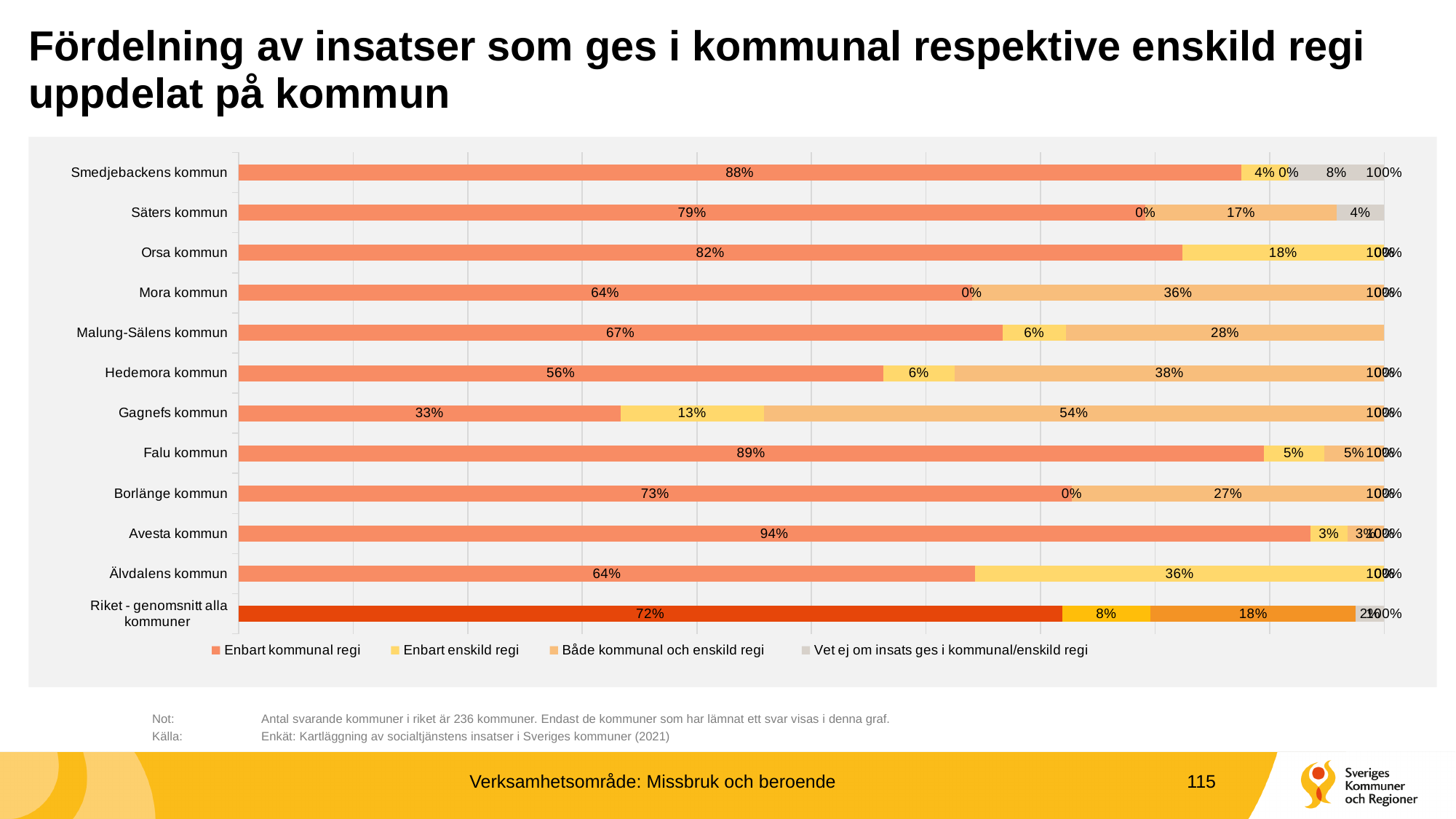
What is the value of 'Vet ej om insats ges i kommunal/enskild regi' for Säters kommun? 4% What kind of chart is shown on the slide? bar chart Which has a larger 'Enbart kommunal regi' value, Mora kommun or Borlänge kommun? Borlänge kommun What is the value of 'Enbart enskild regi' for Älvdalens kommun? 36% Which category has the highest value for 'Både kommunal och enskild regi'? Gagnefs kommun How many categories (rows) are plotted in the chart? 12 Which category has the lowest value for 'Enbart kommunal regi'? Gagnefs kommun Which category has the highest value for 'Enbart kommunal regi'? Avesta kommun What is the value of 'Både kommunal och enskild regi' for Hedemora kommun? 38% How many series does the legend list? 4 What is the difference in 'Enbart kommunal regi' between Avesta kommun and Gagnefs kommun? 61 percentage points What is the value of 'Enbart kommunal regi' for Gagnefs kommun? 33%